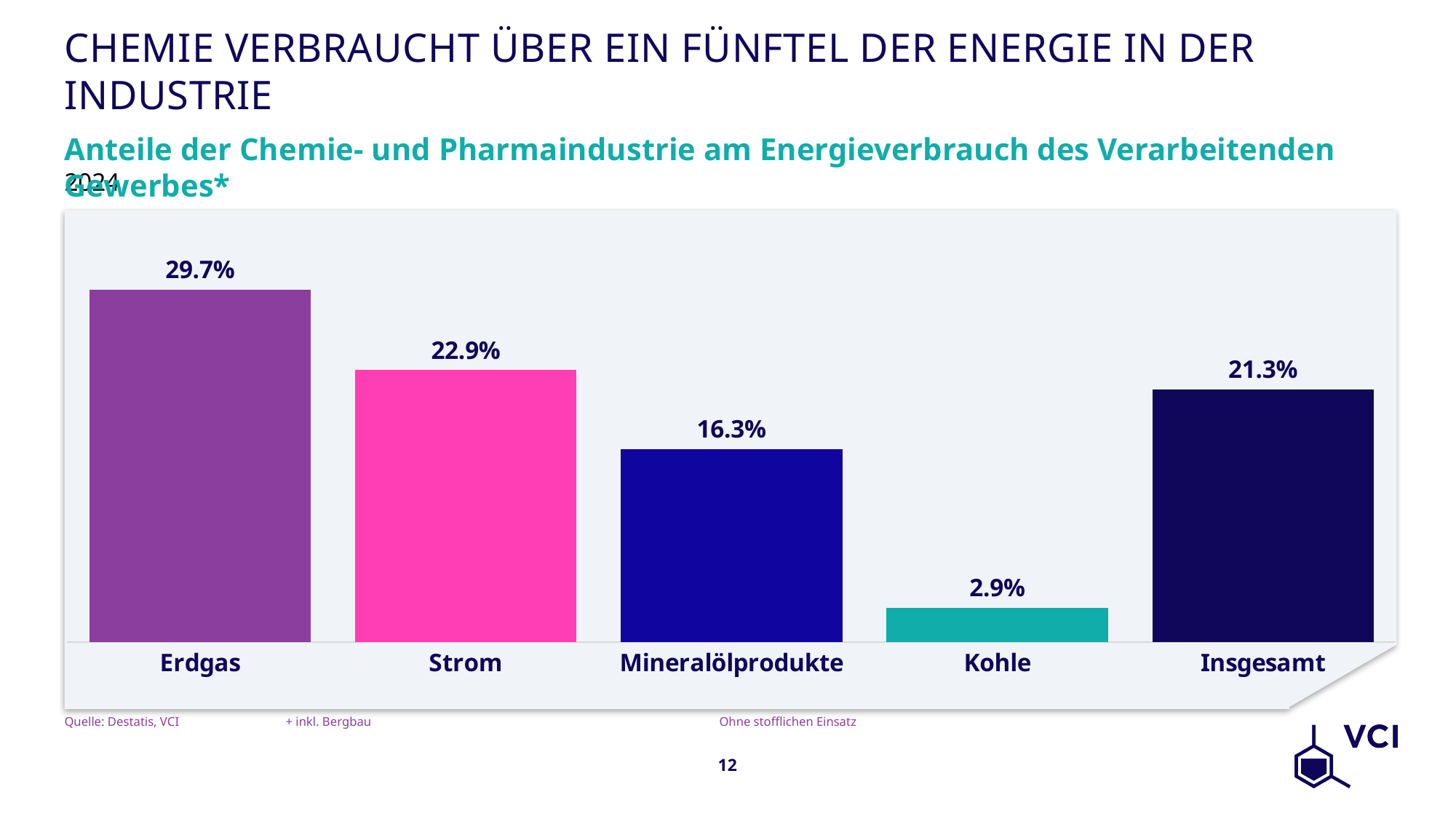
What is the value for Kohle? 2.9% How many categories are shown in the chart? 5 Which is larger, the value for Strom or the value for Insgesamt? Strom Which category has the highest value? Erdgas What is the value for Insgesamt? 21.3% What kind of chart is shown on the slide? Bar chart What is the value for Strom? 22.9% What is the value for Erdgas? 29.7% What is the difference between the values for Erdgas and Strom? 6.8% What is the difference between the values for Insgesamt and Mineralölprodukte? 5.0% Which category has the lowest value? Kohle What is the value for Mineralölprodukte? 16.3%